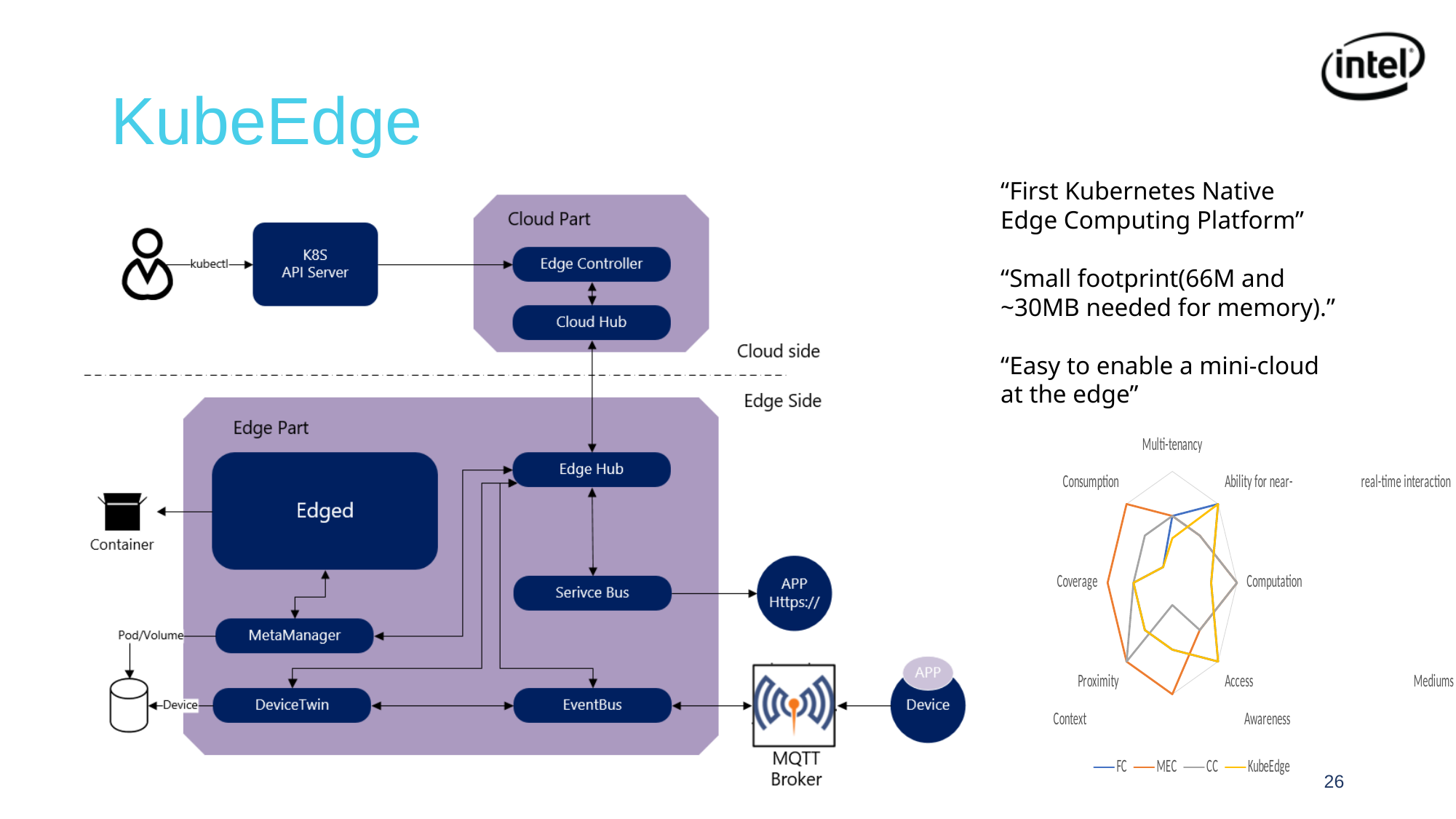
What kind of chart is shown at the bottom right of the slide? radar chart How many series does the legend of the radar chart list? 4 In the radar chart, which series extends further along the Coverage axis, MEC or KubeEdge? MEC In the radar chart, which series covers the largest overall area? MEC In the radar chart, which series extends further along the Computation axis, CC or KubeEdge? CC Which series in the radar chart is drawn in orange? MEC Which series in the radar chart is drawn in yellow? KubeEdge